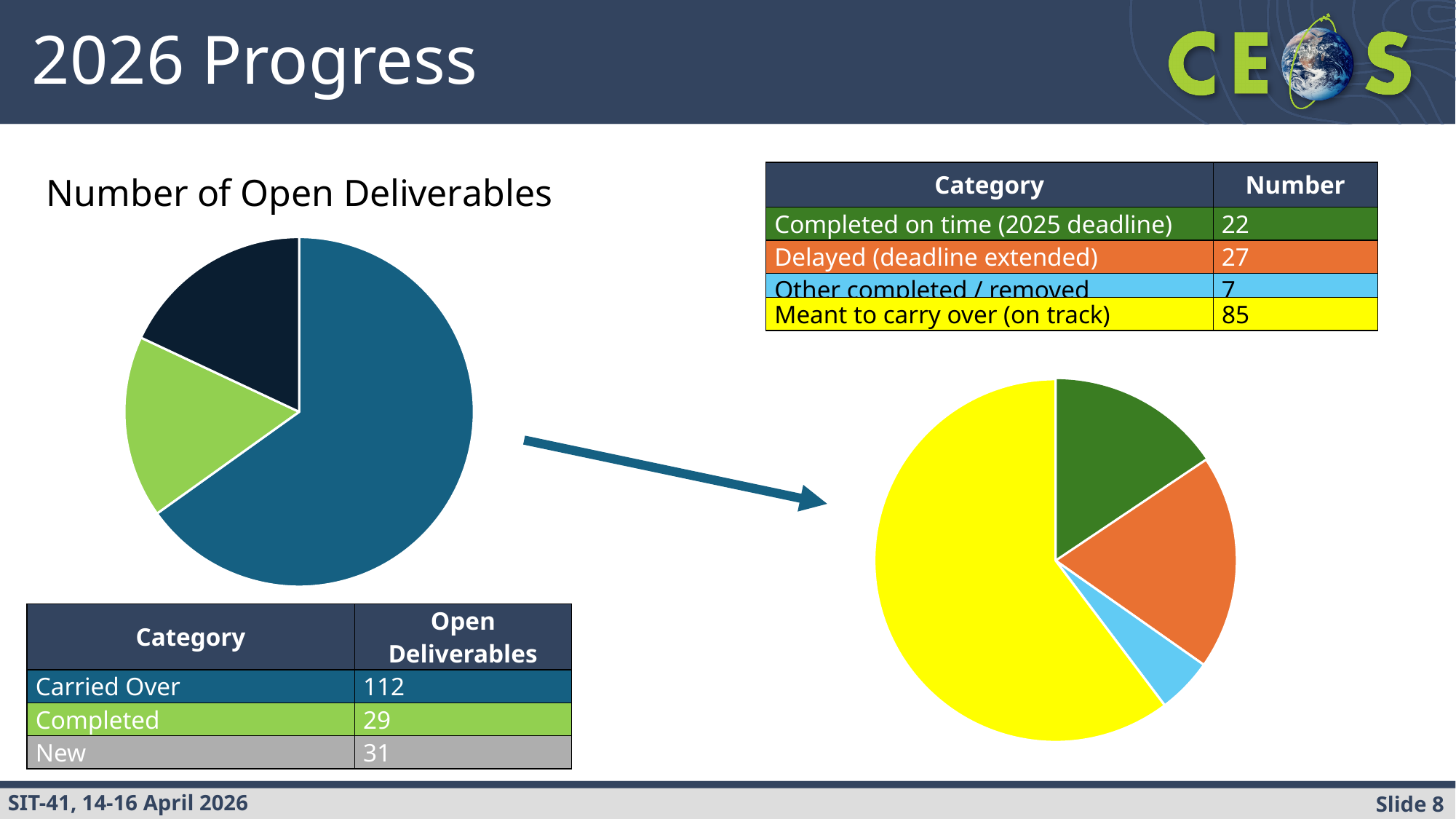
In the 'Number of Open Deliverables' chart on the left, how many open deliverables are Completed? 29 In the 'Number of Open Deliverables' chart on the left, which category has the largest number of open deliverables? Carried Over In the 'Number of Open Deliverables' chart on the left, what is the total number of open deliverables across all categories? 172 In the pie chart on the right, how many deliverables were Delayed (deadline extended)? 27 In the pie chart on the right, how many categories are shown? 4 What kind of chart is the 'Number of Open Deliverables' chart on the left? pie chart In the 'Number of Open Deliverables' chart on the left, what is the difference between Carried Over and New? 81 In the pie chart on the right, which is larger: Completed on time (2025 deadline) or Delayed (deadline extended)? Delayed (deadline extended) In the pie chart on the right, what colour is the slice for Meant to carry over (on track)? yellow In the 'Number of Open Deliverables' chart on the left, how many open deliverables are Carried Over? 112 In the pie chart on the right, which category has the smallest number? Other completed / removed In the 'Number of Open Deliverables' chart on the left, how many categories are shown? 3